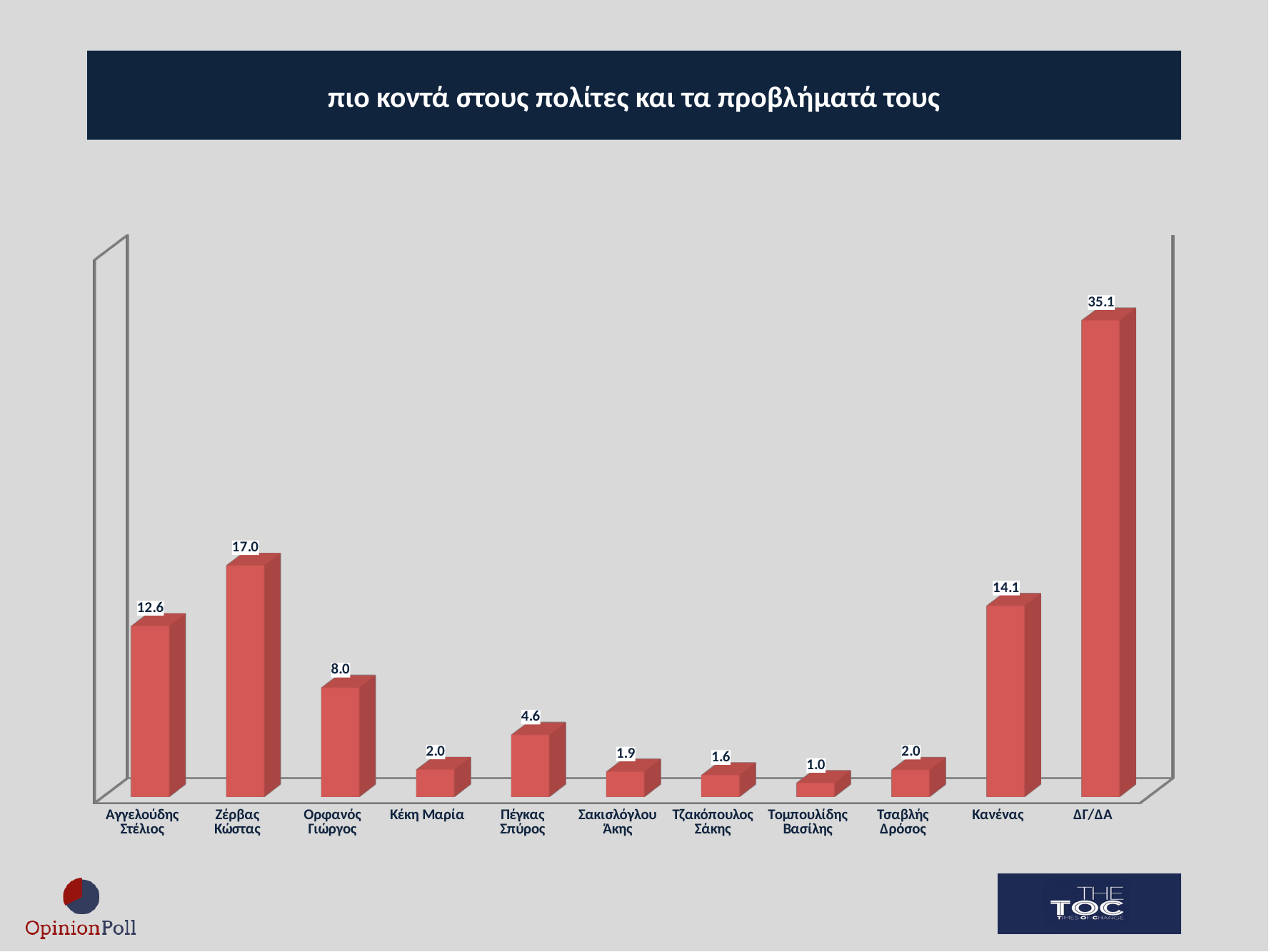
What is the value for Ζέρβας Κώστας? 17.0 What is the difference between the values for ΔΓ/ΔΑ and Ζέρβας Κώστας? 18.1 Which category has the highest value? ΔΓ/ΔΑ What is the title of the chart? πιο κοντά στους πολίτες και τα προβλήματά τους How many categories are shown on the x axis? 11 What is the value for Τομπουλίδης Βασίλης? 1.0 What is the value for Αγγελούδης Στέλιος? 12.6 What is the value for Κανένας? 14.1 What is the difference between the values for Ορφανός Γιώργος and Πέγκας Σπύρος? 3.4 Which is larger, the value for Κανένας or the value for Αγγελούδης Στέλιος? Κανένας Which category has the lowest value? Τομπουλίδης Βασίλης What kind of chart is shown on the slide? bar chart